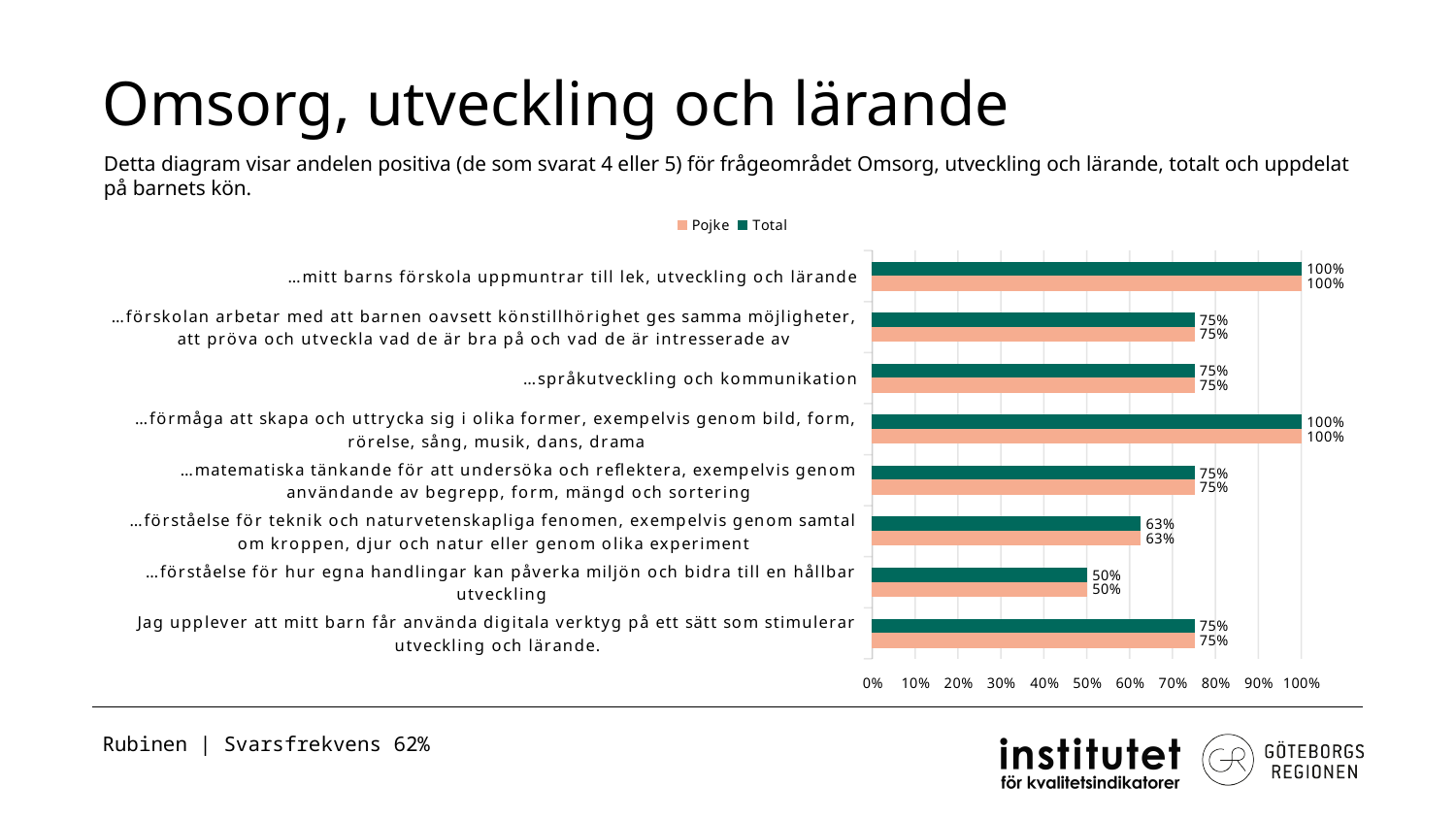
Which category has the lowest Total value? …förståelse för hur egna handlingar kan påverka miljön och bidra till en hållbar utveckling How many categories are plotted in the chart? 8 What is the Pojke value for "…förståelse för teknik och naturvetenskapliga fenomen, exempelvis genom samtal om kroppen, djur och natur eller genom olika experiment"? 63% What kind of chart is shown on the slide? bar chart How many series does the legend list? 2 Which series is shown in dark green in the legend? Total What is the Total value for "…språkutveckling och kommunikation"? 75% What is the Total value for "…förståelse för hur egna handlingar kan påverka miljön och bidra till en hållbar utveckling"? 50% Which is larger: the Pojke value for "…språkutveckling och kommunikation" or the Pojke value for "…förståelse för teknik och naturvetenskapliga fenomen, exempelvis genom samtal om kroppen, djur och natur eller genom olika experiment"? …språkutveckling och kommunikation What is the difference between the Pojke value for "…matematiska tänkande för att undersöka och reflektera, exempelvis genom användande av begrepp, form, mängd och sortering" and the Pojke value for "…förståelse för teknik och naturvetenskapliga fenomen, exempelvis genom samtal om kroppen, djur och natur eller genom olika experiment"? 12% What is the Pojke value for "…mitt barns förskola uppmuntrar till lek, utveckling och lärande"? 100% What is the difference between the Total value for "…mitt barns förskola uppmuntrar till lek, utveckling och lärande" and the Total value for "…förståelse för hur egna handlingar kan påverka miljön och bidra till en hållbar utveckling"? 50%